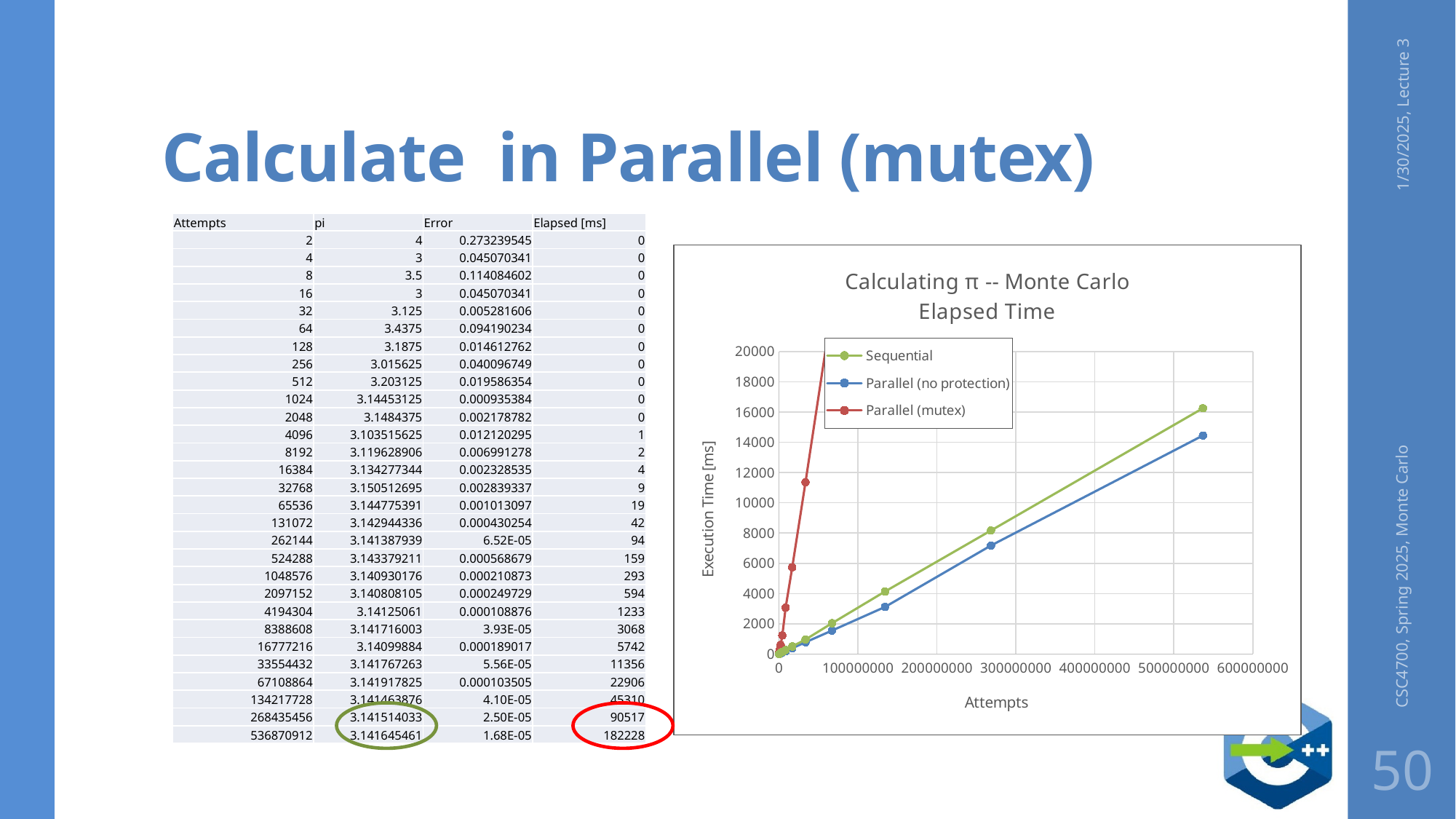
Which series rises most steeply with Attempts? Parallel (mutex) Does the Sequential series rise or fall as Attempts increase? rise How many series does the chart's legend list? 3 What is the title of the chart? Calculating π -- Monte Carlo Elapsed Time Is the Sequential execution time at roughly 270000000 Attempts greater or less than 10000? less What kind of chart is shown on the slide? line chart Does the Parallel (mutex) series exceed 20000 ms within the plotted range? yes Is the Sequential execution time at the largest number of Attempts greater or less than 15000? greater At the largest number of Attempts plotted, which is higher: Sequential or Parallel (no protection)? Sequential What is the highest tick value shown on the y axis of the chart? 20000 What are the three series named in the chart's legend? Sequential, Parallel (no protection), Parallel (mutex)